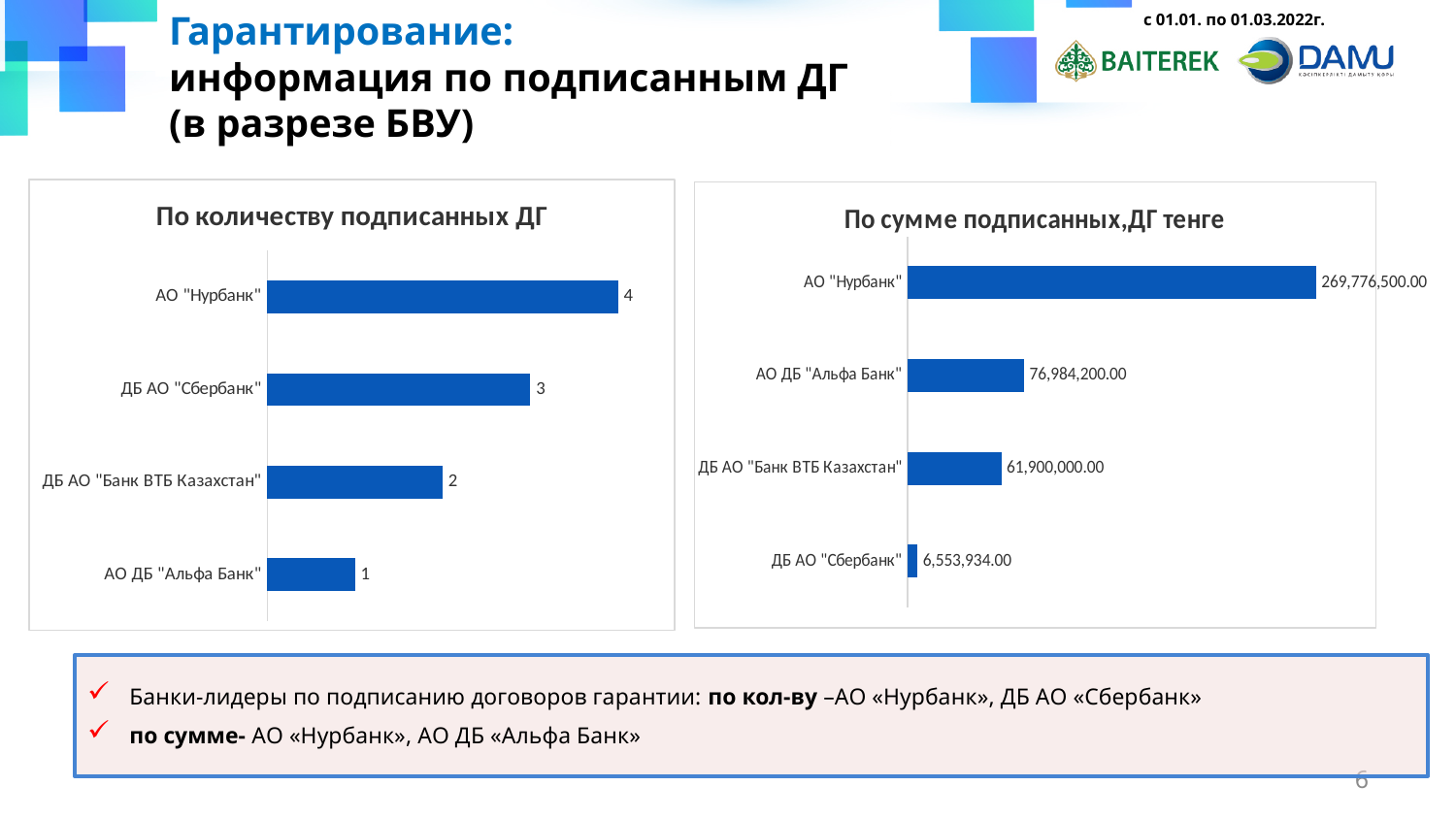
In the chart "По количеству подписанных ДГ", what is the value for АО "Нурбанк"? 4 In the chart "По количеству подписанных ДГ", what is the difference between АО "Нурбанк" and ДБ АО "Сбербанк"? 1 In the chart "По сумме подписанных,ДГ тенге", which bank has the highest value? АО "Нурбанк" In the chart "По сумме подписанных,ДГ тенге", what is the value for АО "Нурбанк"? 269,776,500.00 What is the title of the chart on the left side of the slide? По количеству подписанных ДГ In the chart "По количеству подписанных ДГ", how many banks are shown? 4 In the chart "По сумме подписанных,ДГ тенге", what is the difference between АО ДБ "Альфа Банк" and ДБ АО "Банк ВТБ Казахстан"? 15,084,200.00 In the chart "По количеству подписанных ДГ", which bank has the lowest value? АО ДБ "Альфа Банк" What type of chart is the chart "По сумме подписанных,ДГ тенге"? Bar chart In the chart "По количеству подписанных ДГ", what is the value for ДБ АО "Банк ВТБ Казахстан"? 2 In the chart "По сумме подписанных,ДГ тенге", what is the value for ДБ АО "Сбербанк"? 6,553,934.00 In the chart "По сумме подписанных,ДГ тенге", which is larger: АО ДБ "Альфа Банк" or ДБ АО "Банк ВТБ Казахстан"? АО ДБ "Альфа Банк"